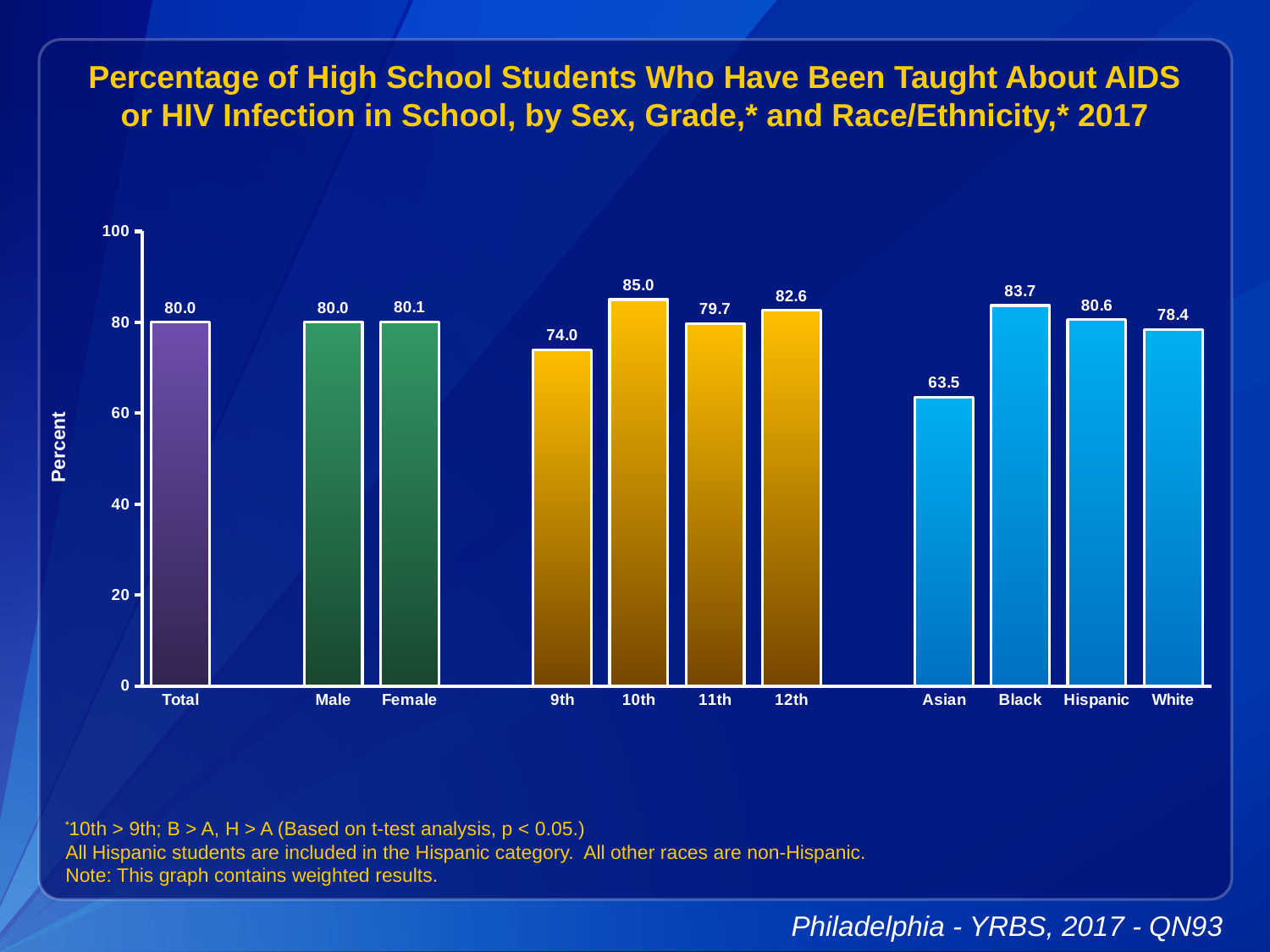
Which is larger, the value for 12th grade or the value for 11th grade? 12th What is the value for 9th grade? 74.0 What is the label of the y axis? Percent How many categories are shown on the x axis? 11 What kind of chart is shown? bar chart What is the difference between the values for Black and Asian students? 20.2 Which category has the lowest value? Asian What is the value for Total? 80.0 Which category has the highest value? 10th What is the value for Asian students? 63.5 Is the value for Asian students greater or less than 80? less What is the difference between the values for 10th and 9th grade? 11.0